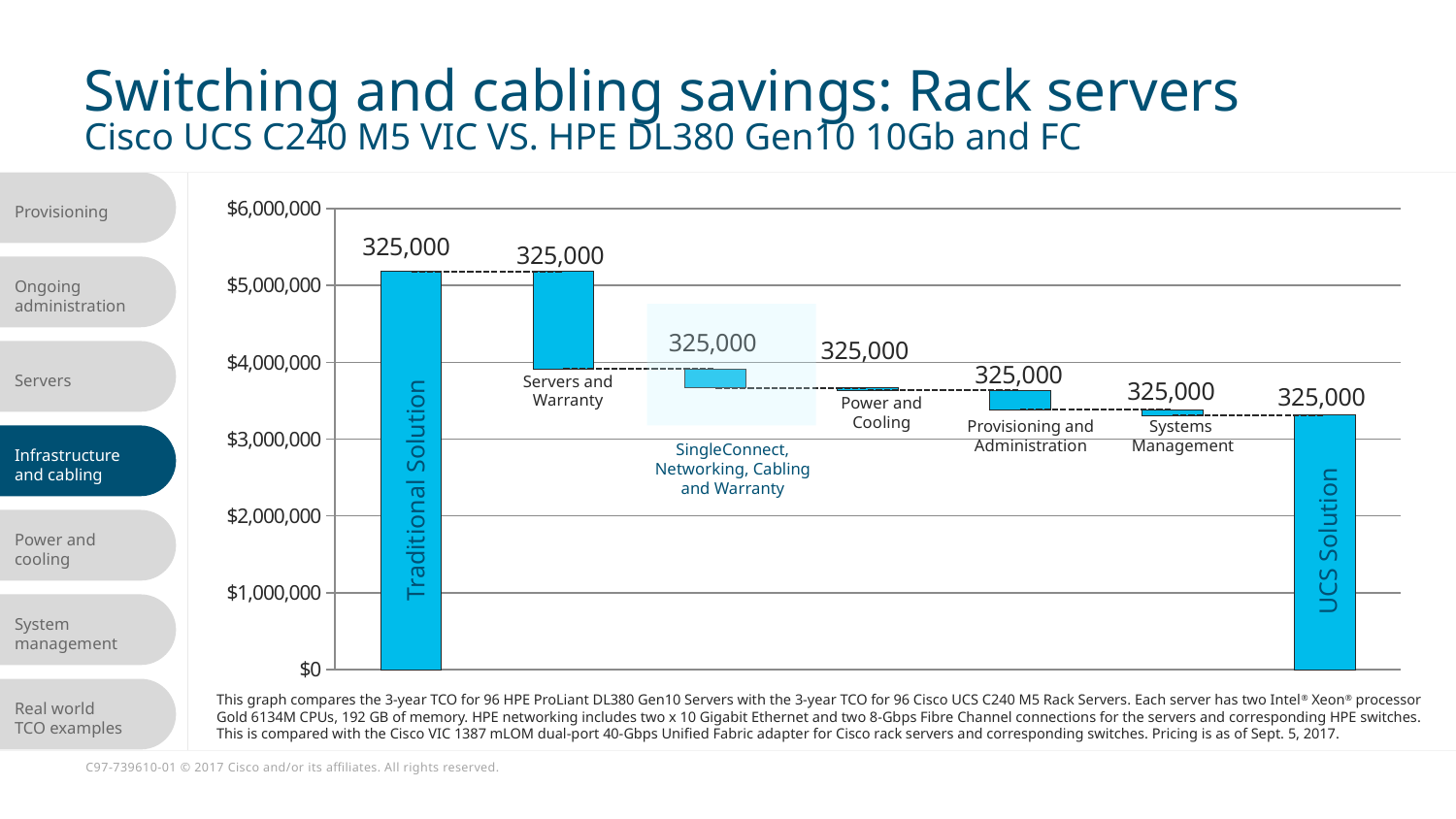
Which category on the chart is highlighted with a shaded box and blue text? SingleConnect, Networking, Cabling and Warranty Is the value for Traditional Solution greater or less than $5,000,000? greater What is the highest value shown on the y axis of the chart? $6,000,000 What type of chart is shown on the slide? bar chart Which category has the tallest bar in the chart? Traditional Solution Which category's bar is the last one on the right of the chart? UCS Solution What data label is printed above the Traditional Solution bar? 325,000 Which is larger, the Traditional Solution bar or the UCS Solution bar? Traditional Solution Is the value for UCS Solution greater or less than $3,000,000? greater How many categories are shown along the x axis of the chart? 7 Do the bar tops fall or rise moving from Traditional Solution across the intermediate categories to UCS Solution? fall Is the value for UCS Solution greater or less than $4,000,000? less